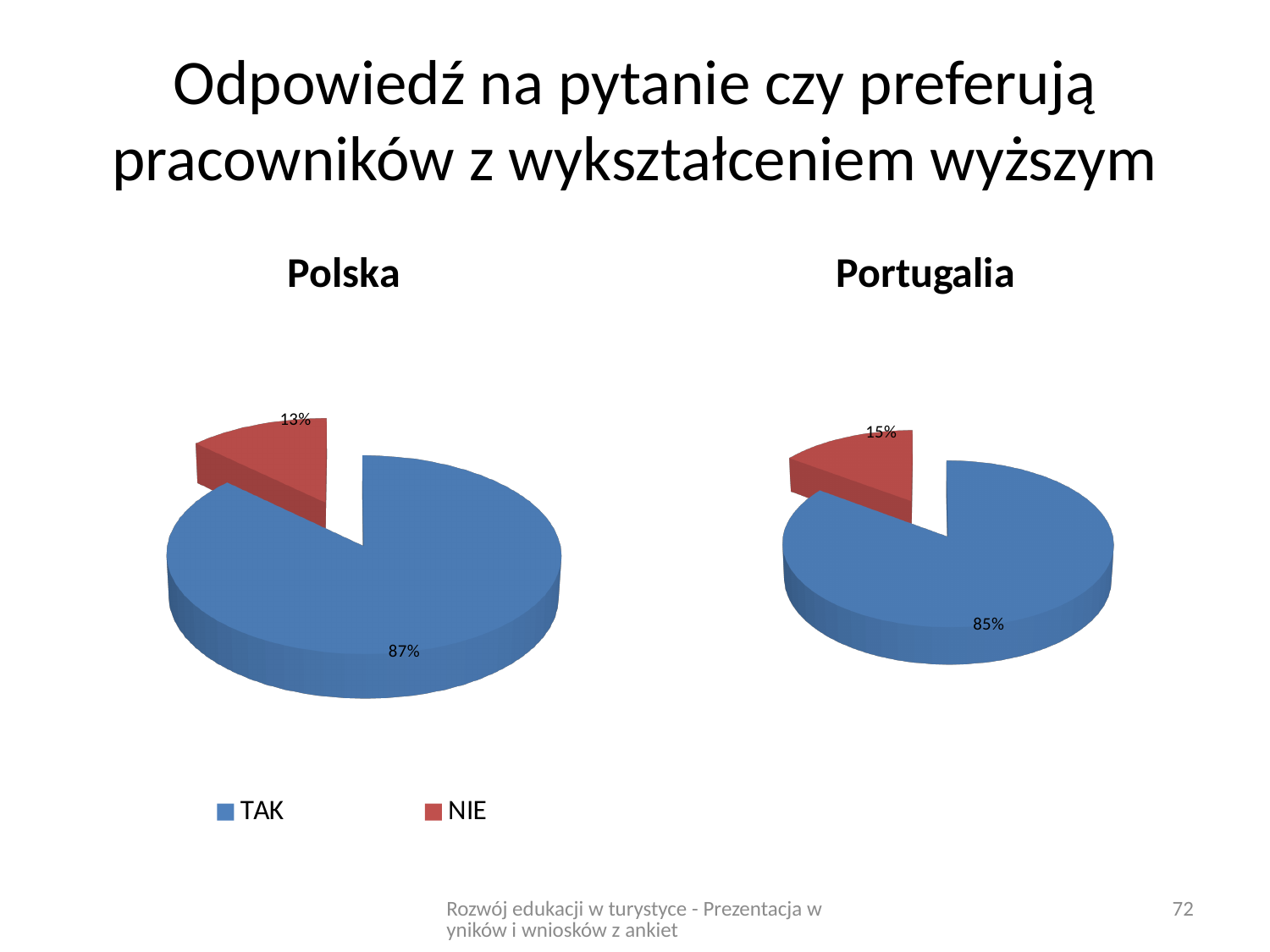
How many slices does the Polska pie chart have? 2 In the Polska chart, what is the difference in percentage points between the TAK and NIE slices? 74 In the Polska chart, what share of respondents answered TAK? 87% What kind of chart is the Portugalia chart? Pie chart In the Polska chart, which answer has the largest slice? TAK How many entries does the legend list? 2 In the Portugalia chart, which answer has the smallest slice? NIE What colour represents NIE in the charts? Red In the Portugalia chart, what share of respondents answered TAK? 85% In the Portugalia chart, what share of respondents answered NIE? 15% Which is larger: the TAK share in the Polska chart or the TAK share in the Portugalia chart? Polska In the Polska chart, what share of respondents answered NIE? 13%